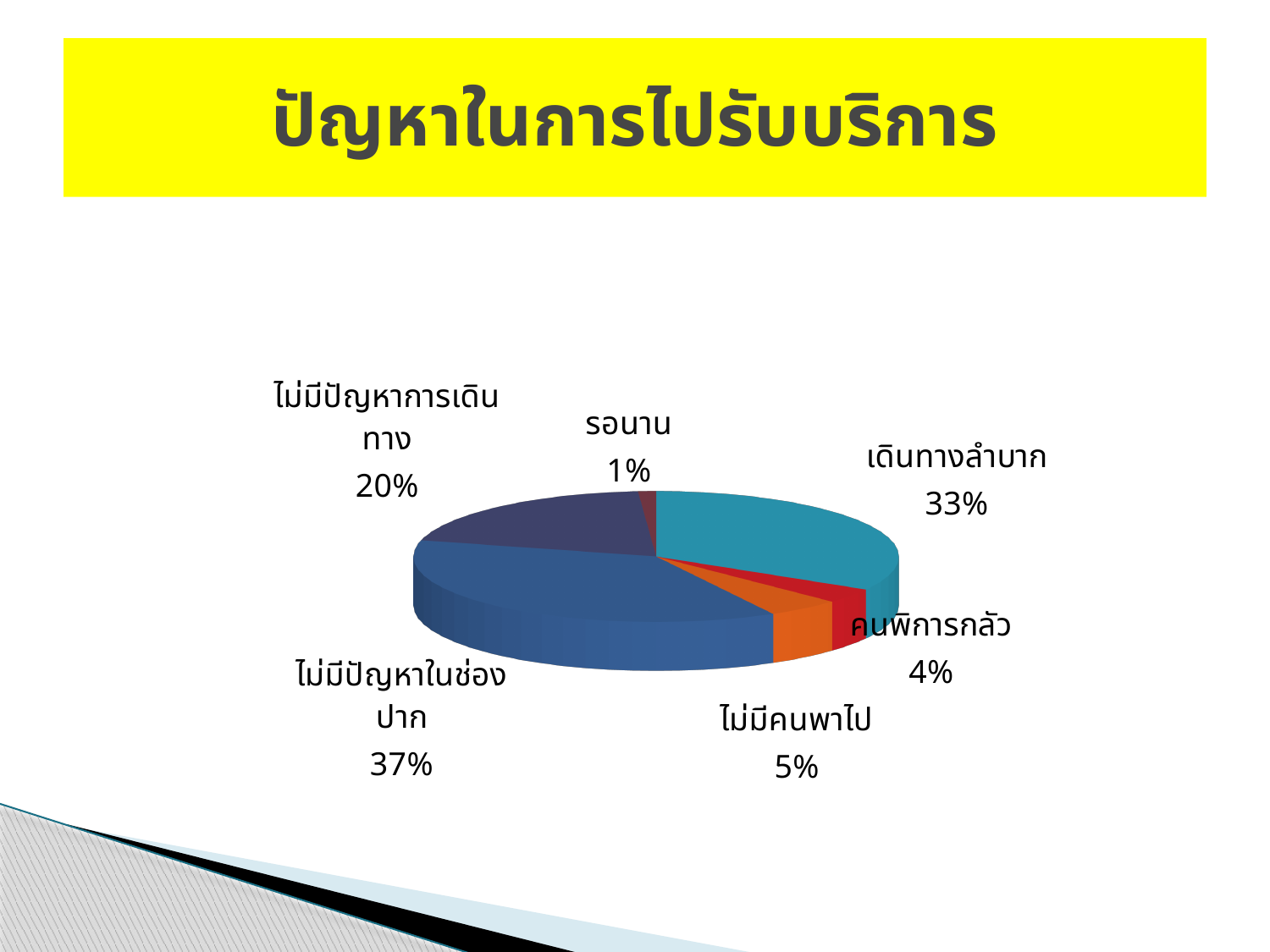
What is the value shown for รอนาน? 1% What is the value shown for คนพิการกลัว? 4% How many categories are shown in the pie chart? 6 Which is larger, the share for ไม่มีปัญหาการเดินทาง or the share for ไม่มีคนพาไป? ไม่มีปัญหาการเดินทาง What kind of chart is shown on the slide? Pie chart What is the difference between the shares for ไม่มีปัญหาในช่องปาก and เดินทางลำบาก? 4% Which category has the largest slice of the pie? ไม่มีปัญหาในช่องปาก Which category has the smallest slice of the pie? รอนาน What share of the pie does ไม่มีปัญหาในช่องปาก represent? 37% What is the title of the slide? ปัญหาในการไปรับบริการ What share of the pie does เดินทางลำบาก represent? 33% What is the value shown for ไม่มีคนพาไป? 5%